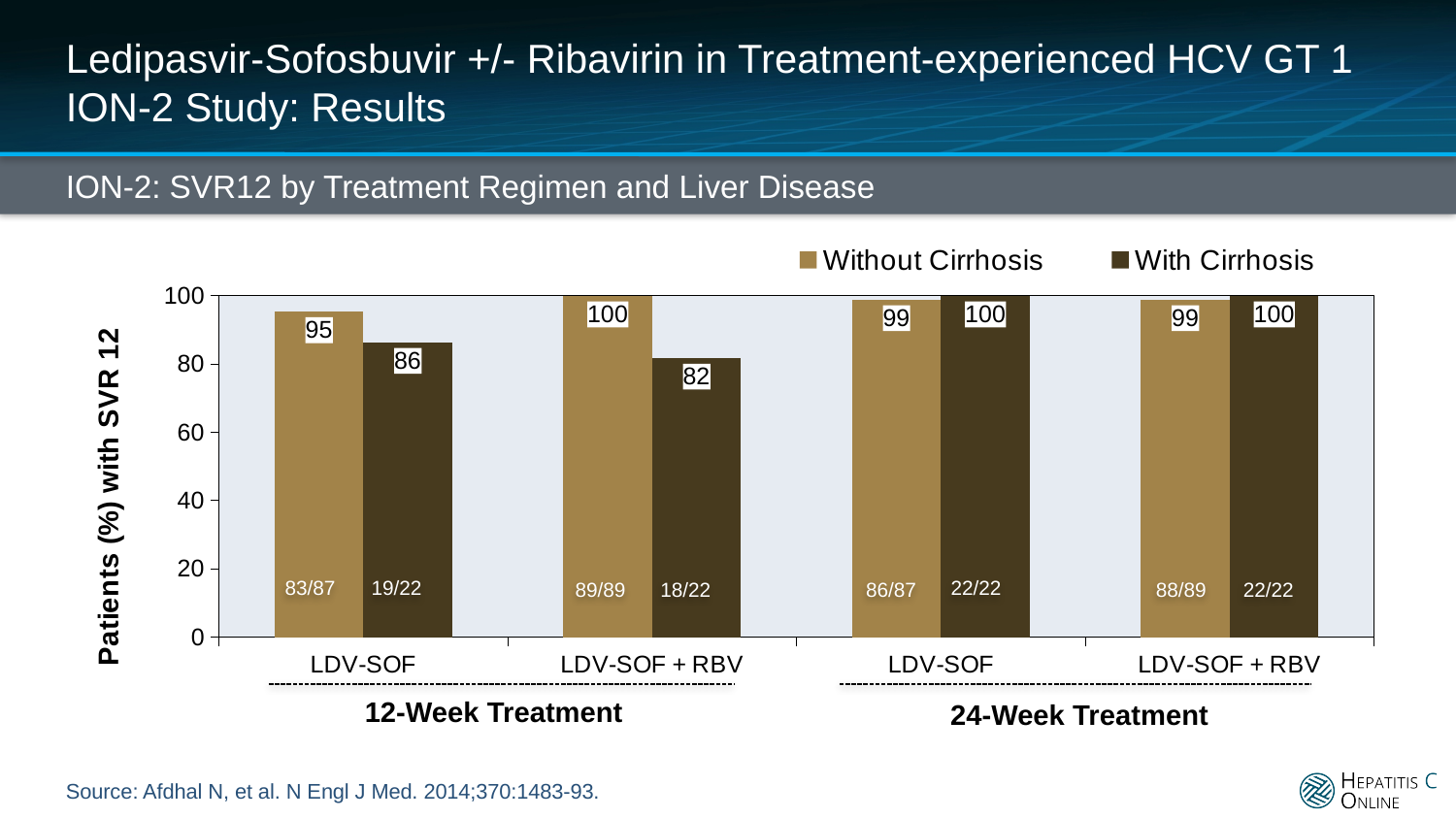
How many patients without cirrhosis achieved SVR12 with LDV-SOF + RBV for 12 weeks, as shown by the fraction on the bar? 89/89 What is the difference in SVR12 rate between patients without cirrhosis and with cirrhosis in the 12-week LDV-SOF group? 9 In the 12-week LDV-SOF + RBV group, which has the higher SVR12 rate: patients without cirrhosis or with cirrhosis? Without Cirrhosis What kind of chart is shown on the slide? Bar chart What is the label of the y axis? Patients (%) with SVR 12 How many treatment regimen categories are shown on the x axis? 4 What is the SVR12 rate for patients with cirrhosis receiving LDV-SOF + RBV for 12 weeks? 82 Which group has the lowest SVR12 rate on the chart? With Cirrhosis, LDV-SOF + RBV, 12-Week Treatment How many series does the legend list? 2 What is the SVR12 rate for patients without cirrhosis receiving LDV-SOF for 12 weeks? 95 What is the SVR12 rate for patients with cirrhosis receiving LDV-SOF for 24 weeks? 100 What is the SVR12 rate for patients without cirrhosis receiving LDV-SOF + RBV for 24 weeks? 99